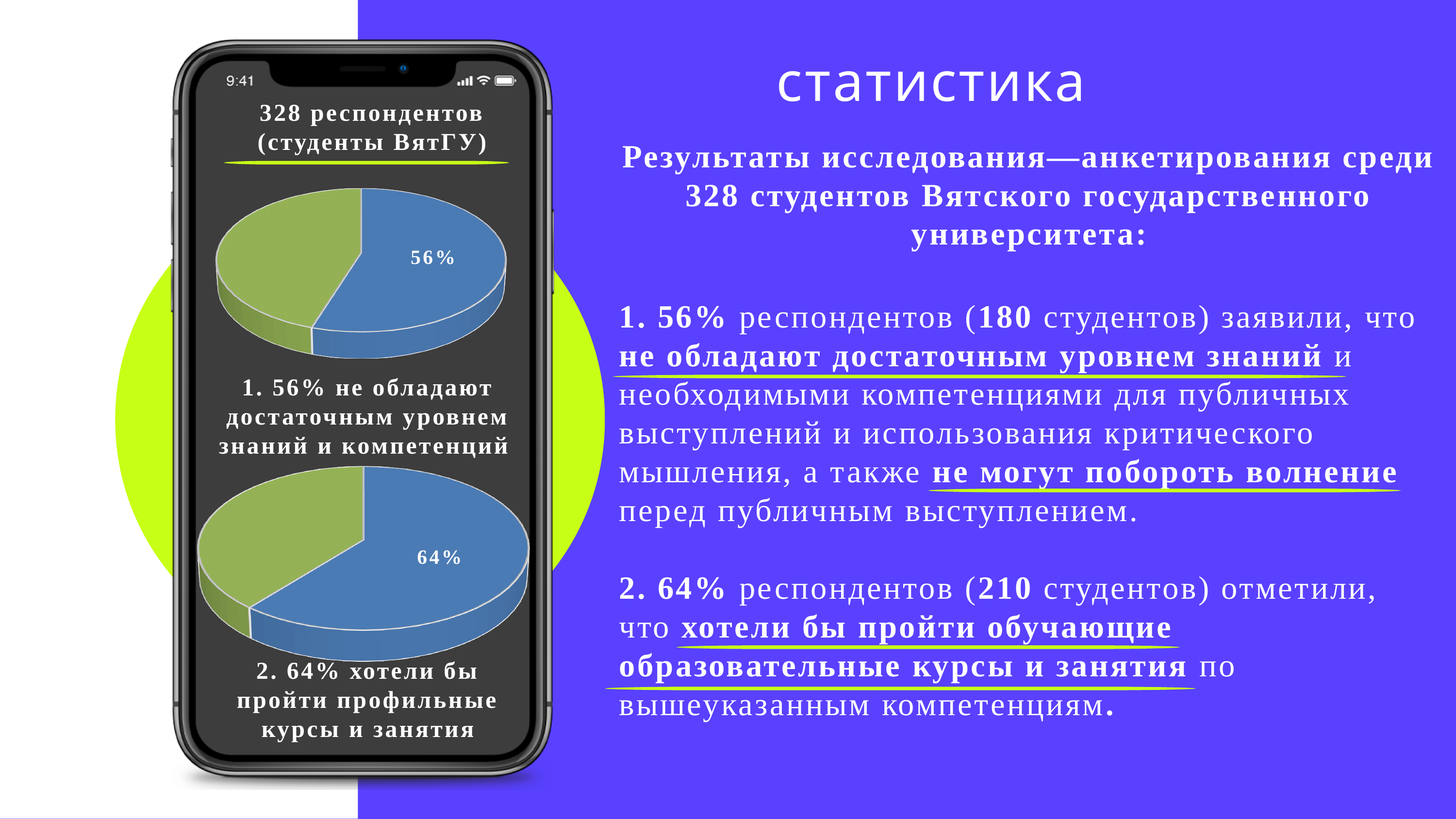
How many slices does the bottom pie chart have? 2 In the top pie chart, what percentage is printed on the blue slice? 56% Which pie chart has the larger labelled blue slice, the top one or the bottom one? bottom What kind of chart is the bottom chart on the phone screen? pie chart What is the difference between the labelled value in the bottom pie chart (64%) and the labelled value in the top pie chart (56%)? 8% What colour is the slice labelled 56% in the top pie chart? blue In the top pie chart, which slice is larger, the blue one or the green one? blue How many slices does the top pie chart have? 2 What kind of chart is the top chart on the phone screen? pie chart According to the heading above the top pie chart, how many respondents took part in the survey? 328 In the bottom pie chart, which slice is larger, the blue one or the green one? blue In the bottom pie chart, what percentage is printed on the blue slice? 64%